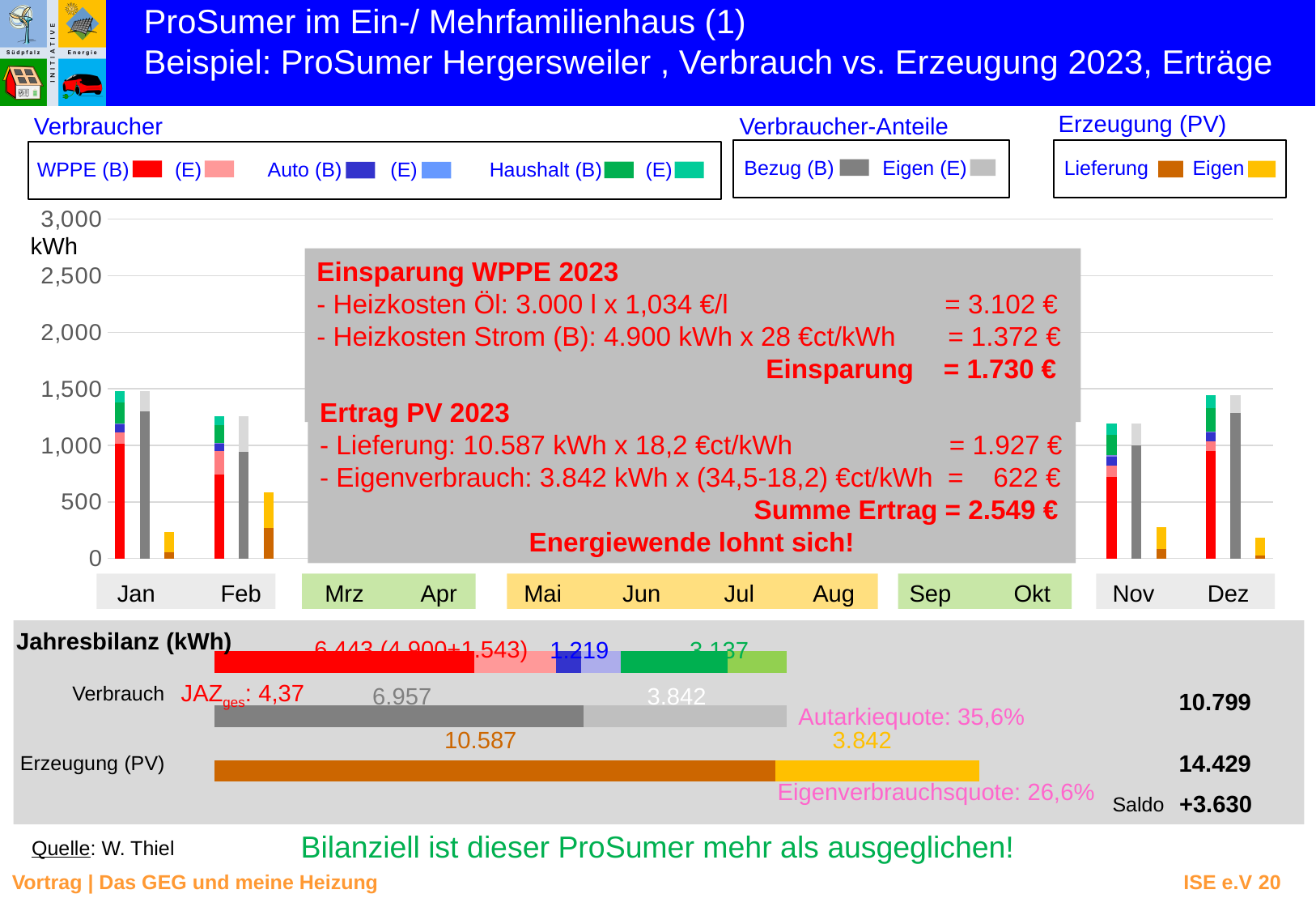
In the Jahresbilanz, what is the total Erzeugung (PV) in kWh? 14.429 In the monthly chart, what unit is shown on the y axis? kWh In the Jahresbilanz, which is larger, Erzeugung (PV) or Verbrauch? Erzeugung (PV) In the Jahresbilanz, what is the Lieferung value of the Erzeugung (PV) bar? 10.587 In the monthly chart, is the yellow Eigen (PV) bar for Jan greater or less than 500 kWh? less How many entries does the Erzeugung (PV) legend list? 2 What kind of chart is the monthly Verbrauch vs. Erzeugung chart? bar chart In the monthly chart, is the total consumption bar for Jan greater or less than 1,000 kWh? greater How many entries does the Verbraucher legend list? 6 In the monthly chart, how many months are shown along the x axis? 12 In the Jahresbilanz, what is the total Verbrauch in kWh? 10.799 In the monthly chart, is the yellow Eigen (PV) bar for Dez greater or less than 500 kWh? less